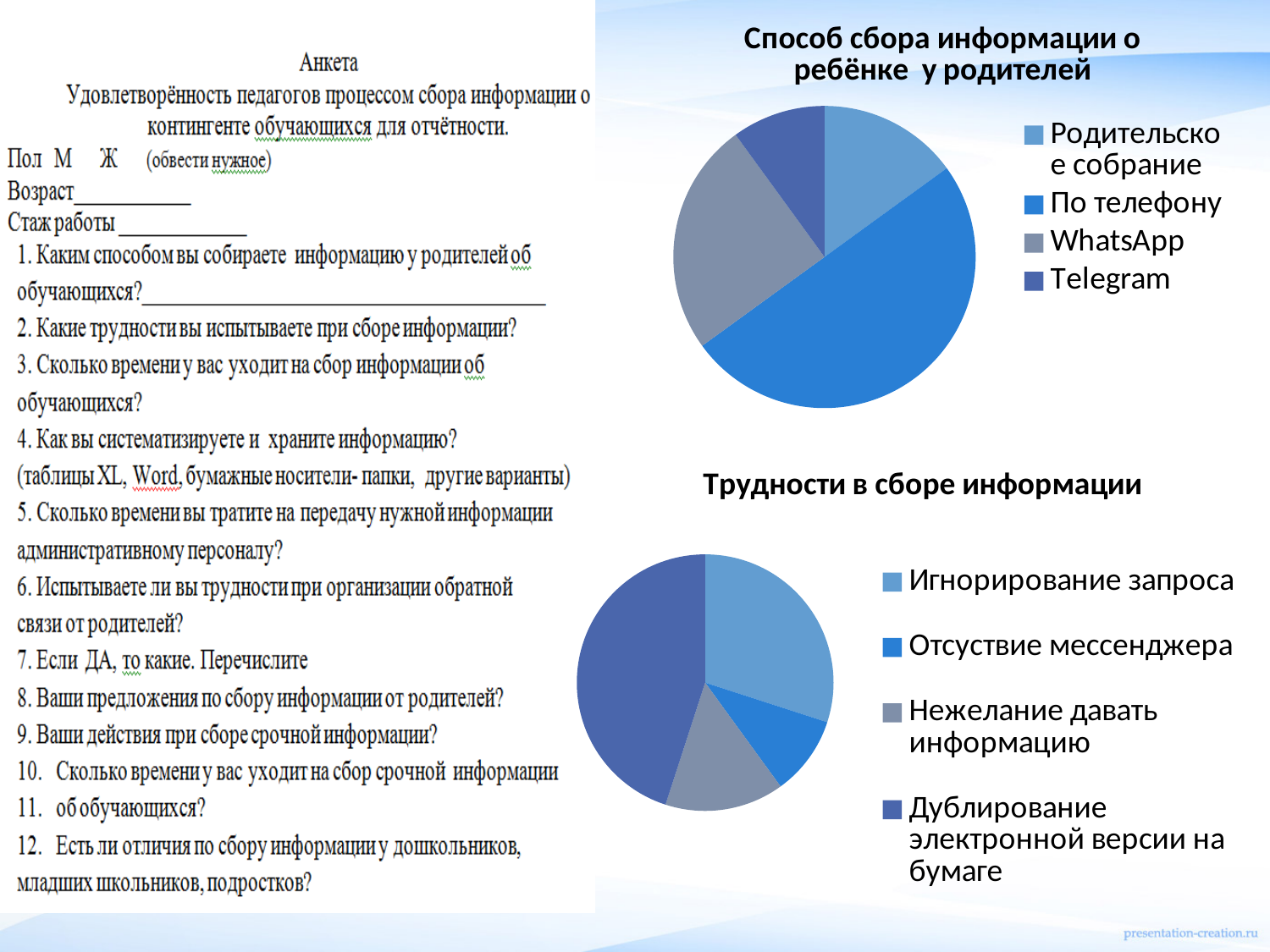
What kind of chart is the chart titled 'Трудности в сборе информации'? pie chart What is the title of the upper chart on the slide? Способ сбора информации о ребёнке у родителей What kind of chart is the chart titled 'Способ сбора информации о ребёнке у родителей'? pie chart In the chart 'Трудности в сборе информации', which slice is larger: Игнорирование запроса or Нежелание давать информацию? Игнорирование запроса In the chart 'Способ сбора информации о ребёнке у родителей', which category has the largest slice? По телефону In the chart 'Способ сбора информации о ребёнке у родителей', which slice is larger: WhatsApp or Родительское собрание? WhatsApp In the chart 'Трудности в сборе информации', how many slices does the pie have? 4 In the chart 'Способ сбора информации о ребёнке у родителей', which category has the smallest slice? Telegram In the chart 'Трудности в сборе информации', which category is shown in grey? Нежелание давать информацию In the chart 'Трудности в сборе информации', which category has the largest slice? Дублирование электронной версии на бумаге In the chart 'Трудности в сборе информации', which category has the smallest slice? Отсуствие мессенджера In the chart 'Способ сбора информации о ребёнке у родителей', how many categories does the legend list? 4